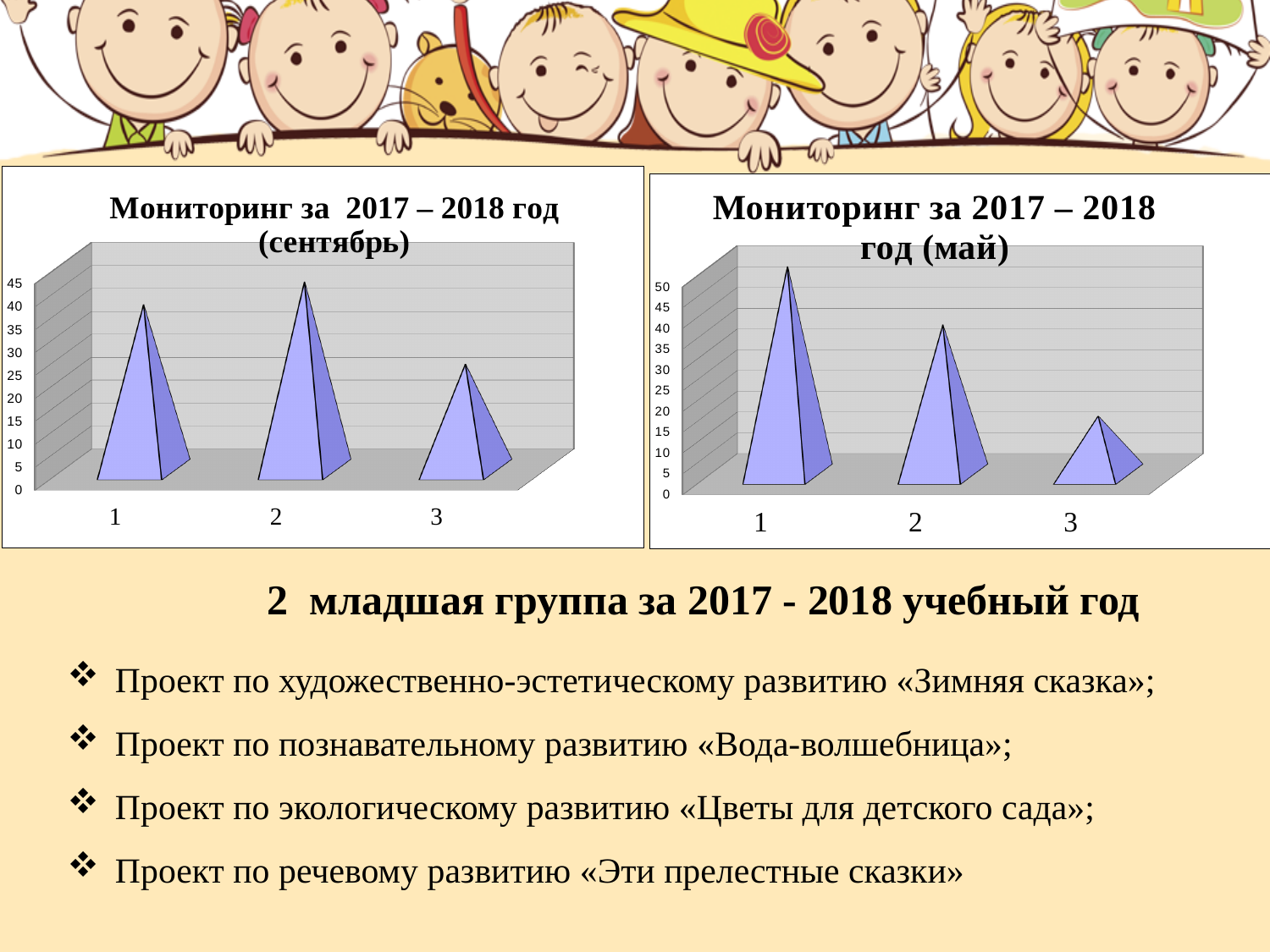
In the chart titled "Мониторинг за 2017 – 2018 год (май)", which category has the lowest value? 3 In the left chart (сентябрь), which is larger: the value for category 1 or category 3? 1 In the right chart (май), which is larger: the value for category 1 or category 2? 1 How many categories are shown in the chart titled "Мониторинг за 2017 – 2018 год (май)"? 3 In the chart titled "Мониторинг за 2017 – 2018 год (май)", which category has the highest value? 1 In the chart titled "Мониторинг за 2017 – 2018 год (сентябрь)", which category has the highest value? 2 In the right chart (май), is the value for category 1 greater or less than 45? greater What kind of chart is the left chart titled "Мониторинг за 2017 – 2018 год (сентябрь)"? bar chart In the chart titled "Мониторинг за 2017 – 2018 год (сентябрь)", which category has the lowest value? 3 In the left chart (сентябрь), is the value for category 3 greater or less than 35? less In the right chart (май), is the value for category 3 greater or less than 25? less